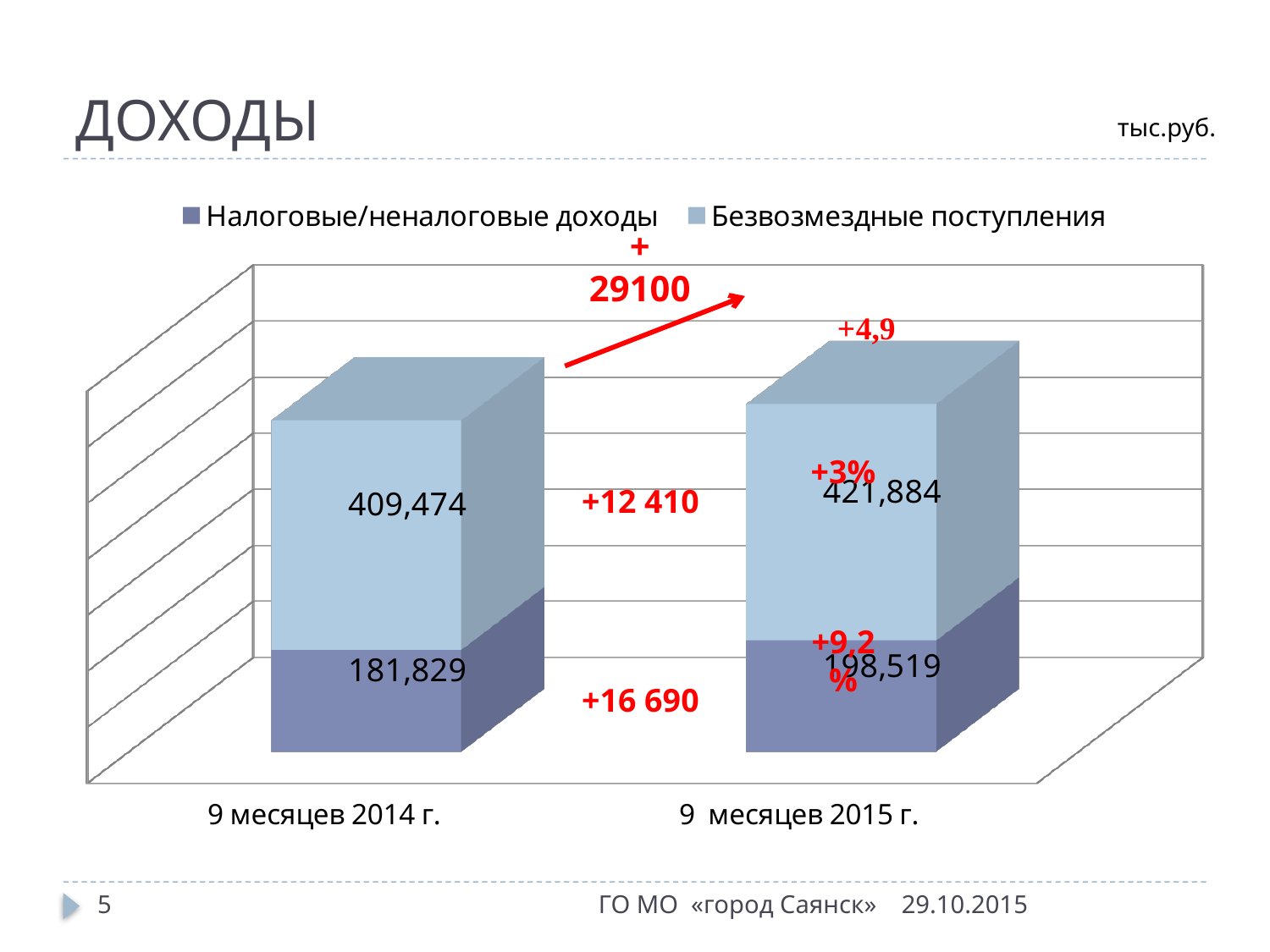
What is the value of Безвозмездные поступления for 9 месяцев 2015 г.? 421,884 By how much did Налоговые/неналоговые доходы increase from 9 месяцев 2014 г. to 9 месяцев 2015 г.? 16,690 What is the total of the stacked bar for 9 месяцев 2014 г.? 591,303 How many categories are shown on the x axis? 2 What is the total of the stacked bar for 9 месяцев 2015 г.? 620,403 What is the value of Налоговые/неналоговые доходы for 9 месяцев 2014 г.? 181,829 What is the value of Налоговые/неналоговые доходы for 9 месяцев 2015 г.? 198,519 What kind of chart is shown on the slide? Stacked bar chart How many series does the legend list? 2 Which is larger for 9 месяцев 2015 г.: Налоговые/неналоговые доходы or Безвозмездные поступления? Безвозмездные поступления By how much did Безвозмездные поступления increase from 9 месяцев 2014 г. to 9 месяцев 2015 г.? 12,410 What is the value of Безвозмездные поступления for 9 месяцев 2014 г.? 409,474